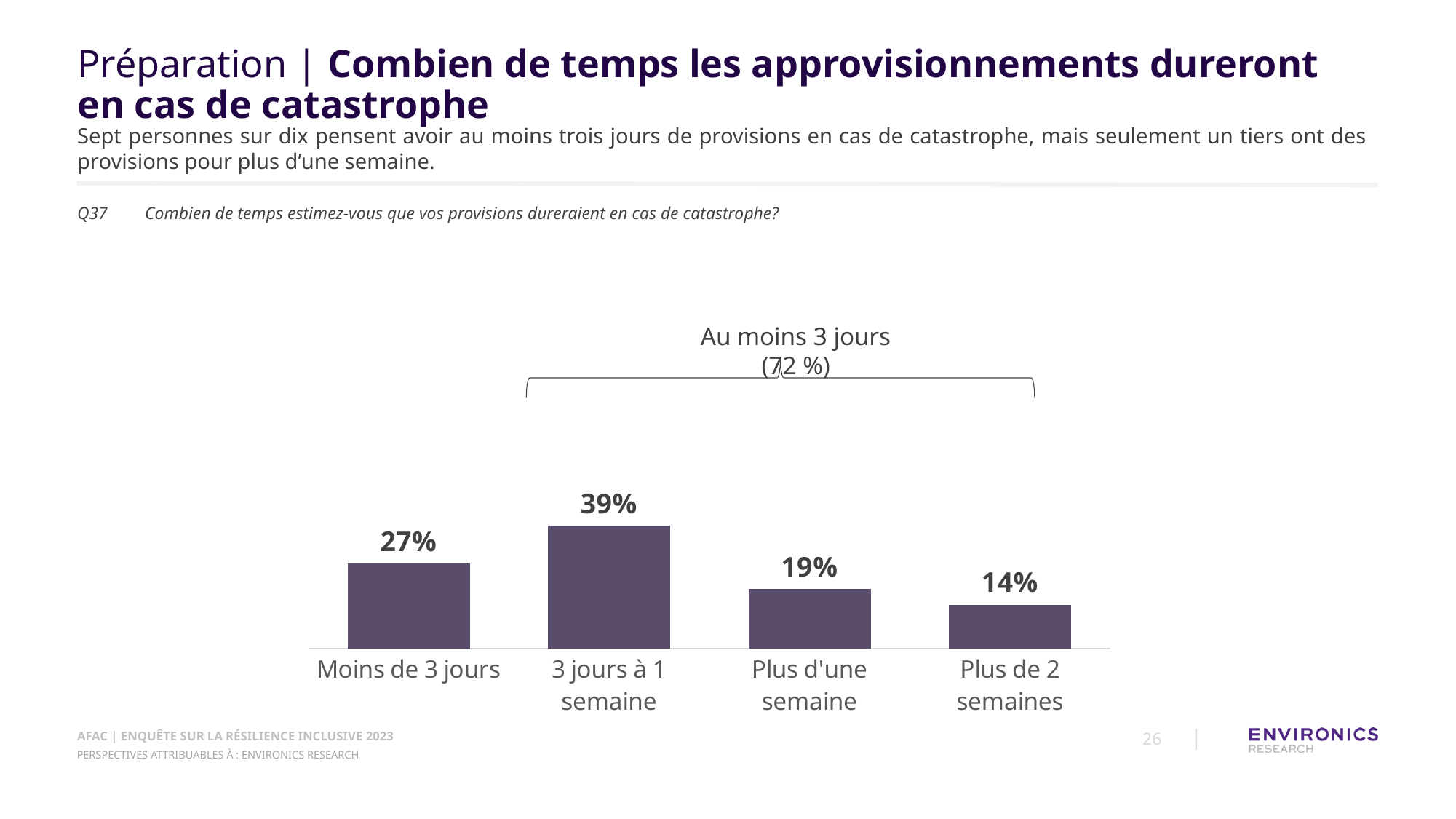
What kind of chart is shown on the slide? Bar chart What is the difference between the values for "Plus d'une semaine" and "Plus de 2 semaines"? 5% What is the value for "Plus d'une semaine"? 19% What is the difference between the values for "3 jours à 1 semaine" and "Moins de 3 jours"? 12% What percentage does the bracket labelled "Au moins 3 jours" above the chart show? 72 % How many categories are shown in the chart? 4 Which category has the lowest value? Plus de 2 semaines What is the value for "Moins de 3 jours"? 27% Which is larger, the value for "Moins de 3 jours" or the value for "Plus d'une semaine"? Moins de 3 jours What is the value for "3 jours à 1 semaine"? 39% Which category has the highest value? 3 jours à 1 semaine What is the value for "Plus de 2 semaines"? 14%